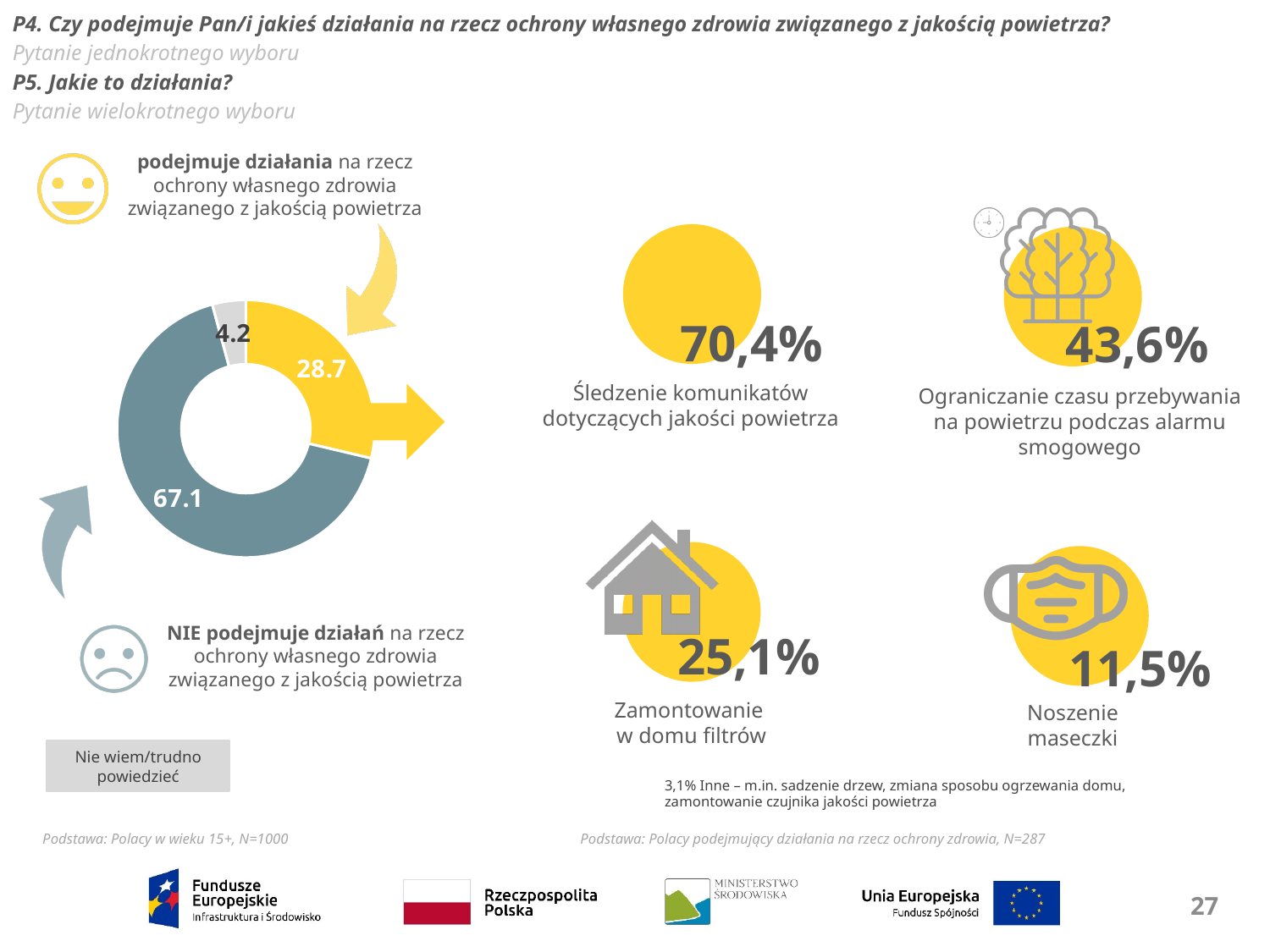
In the donut chart, what value is shown for the slice 'Nie wiem/trudno powiedzieć'? 4.2 What is the total of the three values shown in the donut chart? 100 In the donut chart, which is larger: the value for 'podejmuje działania' or the value for 'NIE podejmuje działań'? NIE podejmuje działań In the donut chart, what is the difference between the 'NIE podejmuje działań' value and the 'podejmuje działania' value? 38.4 In the donut chart, which category has the largest slice? NIE podejmuje działań In the donut chart, which category has the smallest slice? Nie wiem/trudno powiedzieć In the donut chart, what value is shown for the slice 'NIE podejmuje działań'? 67.1 How many slices does the donut chart have? 3 In the infographic on the right, which action has the highest percentage? Śledzenie komunikatów dotyczących jakości powietrza (70,4%) In the donut chart, what colour is the slice for 'podejmuje działania'? yellow What kind of chart is shown on the left of the slide? pie (donut) chart In the donut chart, what value is shown for the yellow slice 'podejmuje działania'? 28.7